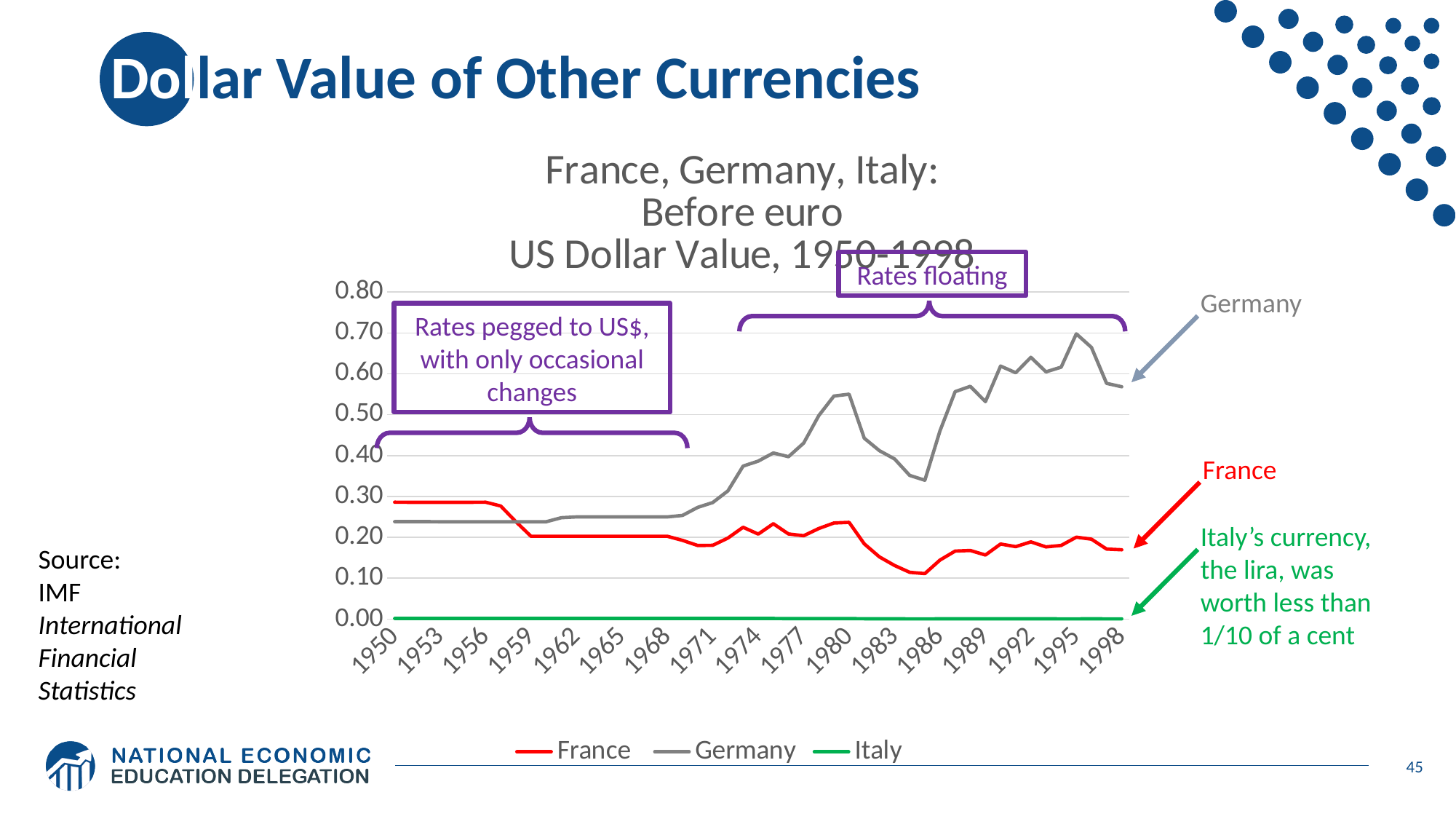
What kind of chart is shown on the slide? line chart How many series does the legend list? 3 Is the value for France in 1986 greater or less than 0.20? less Which series has the highest US dollar value in 1998? Germany Which currencies are listed in the chart legend? France, Germany, Italy What is the title of the chart? France, Germany, Italy: Before euro US Dollar Value, 1950-1998 Is the value for Germany in 1950 greater or less than 0.30? less Does the Germany line generally rise or fall from 1950 to 1998? rise How many year labels are shown on the x axis? 17 Is the value for Germany in 1995 greater or less than 0.60? greater Which is larger in 1950, the value for France or the value for Germany? France Which series has the lowest US dollar value throughout the chart? Italy